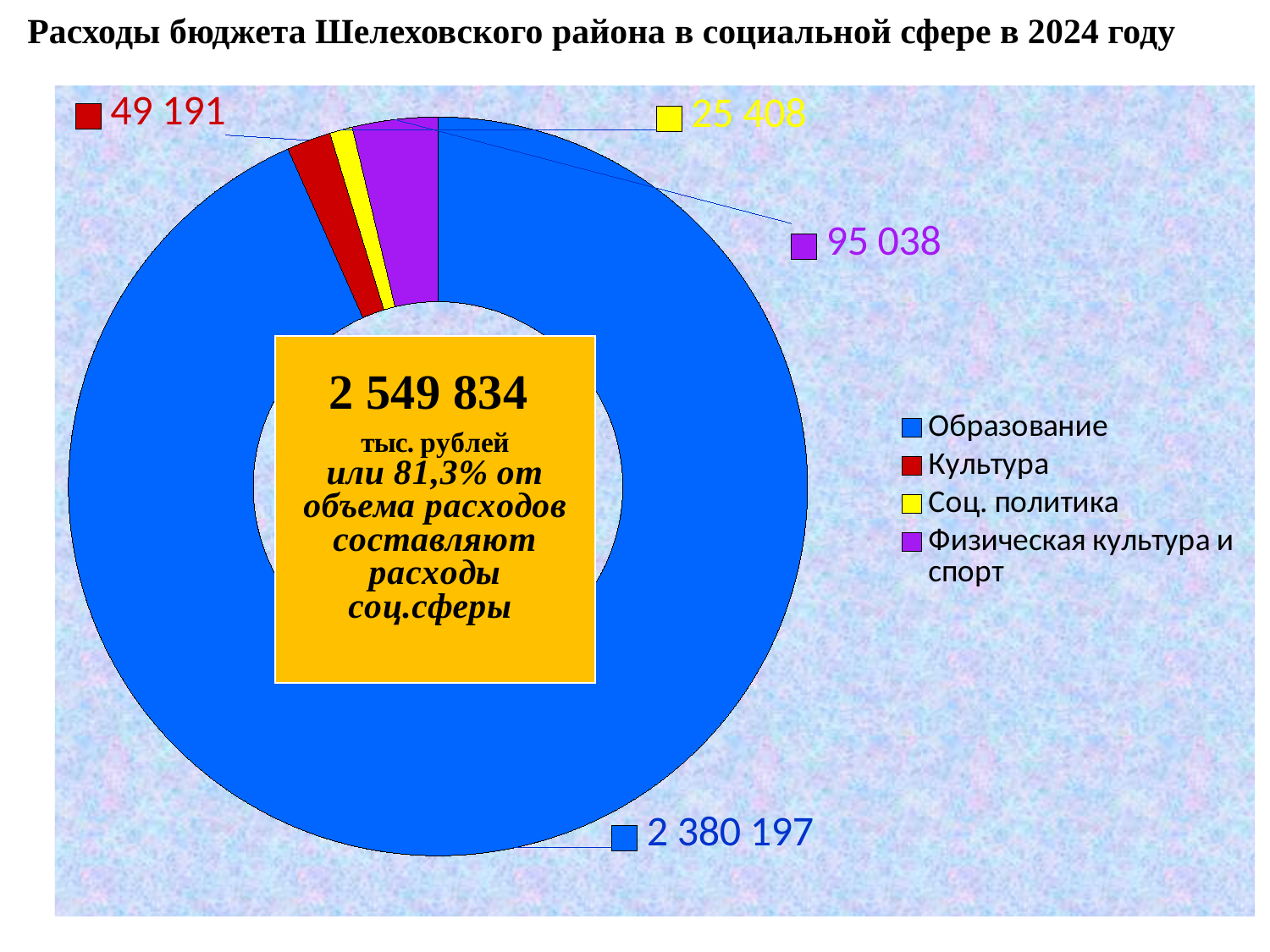
What is the value for Соц. политика in the chart? 25 408 What is the title of the slide? Расходы бюджета Шелеховского района в социальной сфере в 2024 году What is the value for Образование in the chart? 2 380 197 Which category has the smallest value in the chart? Соц. политика What is the value for Культура in the chart? 49 191 Which category has the largest value in the chart? Образование What is the difference between the values for Физическая культура и спорт and Культура? 45 847 How many categories does the chart show? 4 What kind of chart is shown on the slide? pie chart (doughnut) What is the value for Физическая культура и спорт in the chart? 95 038 Which is larger: the value for Культура or the value for Соц. политика? Культура What total is shown in the centre of the chart? 2 549 834